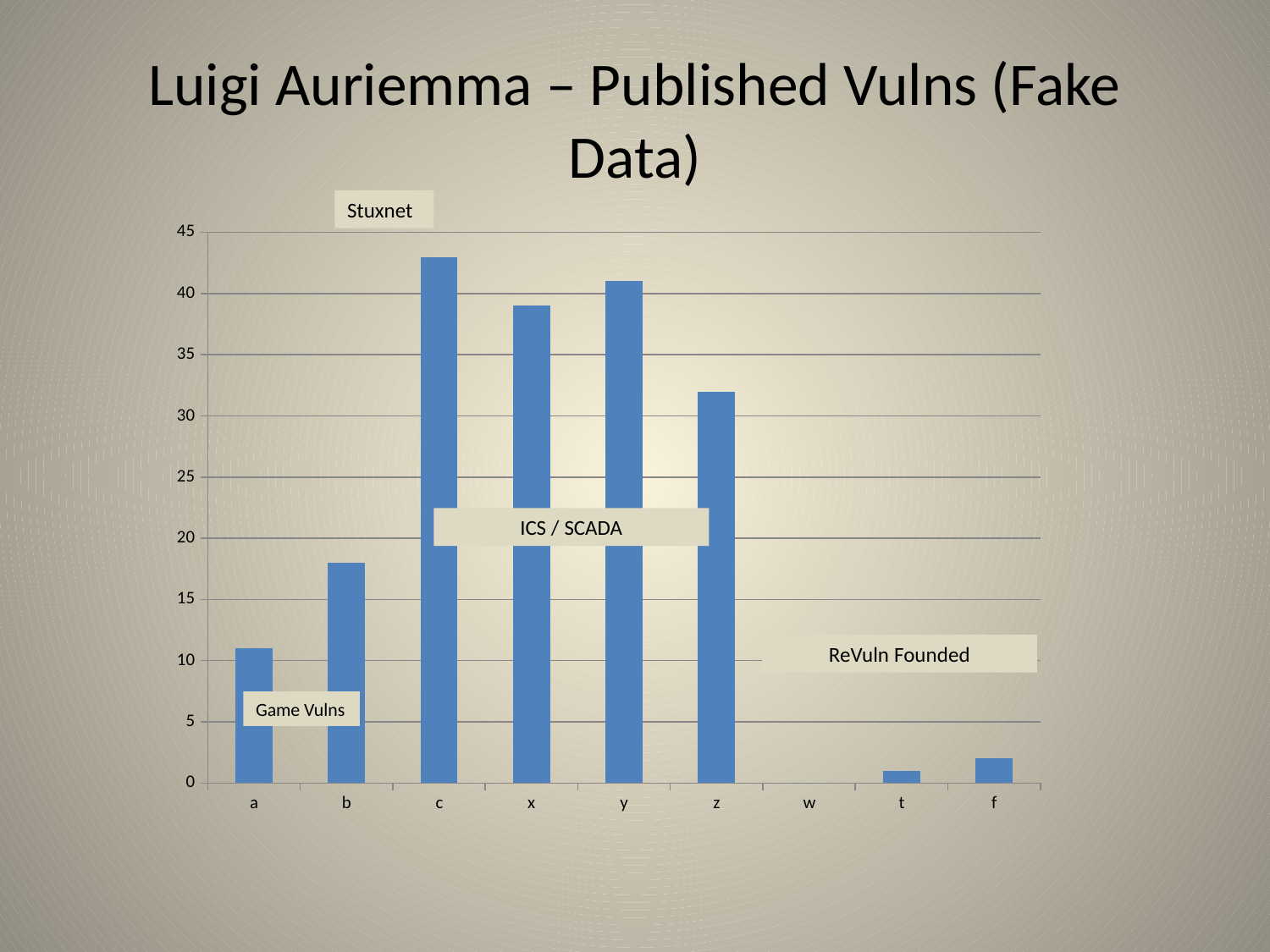
Is the value for t greater or less than 5? less How many categories are shown on the x axis of the chart? 9 Is the value for z greater or less than 30? greater Which has a larger value, a or b? b Which category has the highest bar in the chart? c Is the value for a greater or less than 15? less What is the title of the chart on the slide? Luigi Auriemma – Published Vulns (Fake Data) What kind of chart is shown on the slide? bar chart Which category has the lowest value in the chart? w Which has a larger value, y or z? y